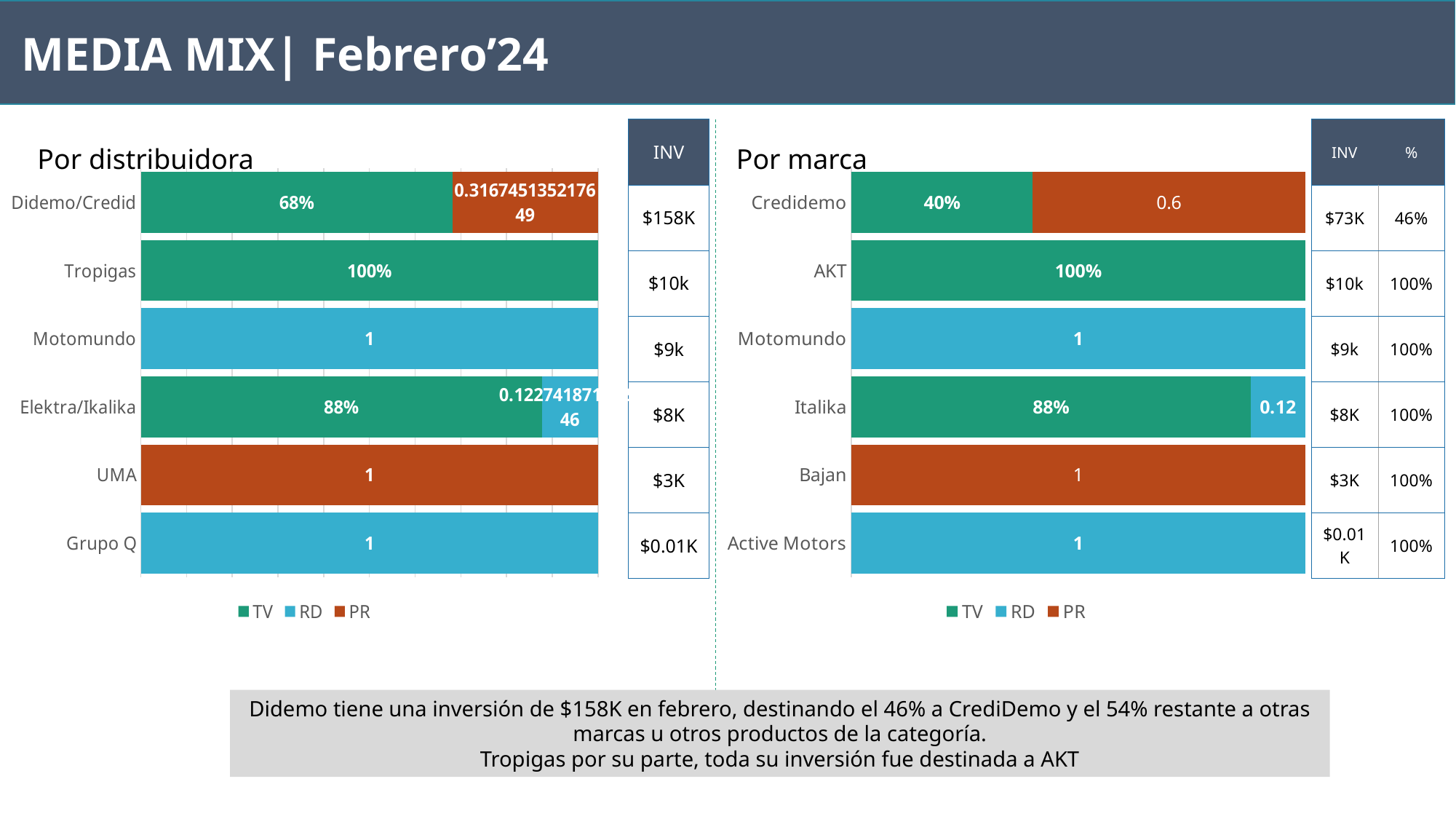
In the 'Por distribuidora' chart, how many distributors are listed? 6 In the 'Por marca' chart, what is the TV share for Credidemo? 40% In the 'Por distribuidora' chart, what is the TV share for Elektra/Ikalika? 88% In the 'Por distribuidora' chart, which series makes up the entire bar for UMA? PR In the 'Por marca' chart, what is the difference between the TV share of AKT and the TV share of Credidemo? 60% What type of chart is the 'Por marca' chart? Stacked bar chart In the 'Por distribuidora' chart, what is the TV share for Tropigas? 100% In the 'Por distribuidora' chart, what is the TV share for Didemo/Credid? 68% In the 'Por marca' chart, what is the PR value shown for Credidemo? 0.6 In the 'Por marca' chart, which has a larger TV share, Credidemo or Italika? Italika In the 'Por marca' chart, what is the RD value shown for Italika? 0.12 In the 'Por distribuidora' chart, how many series does the legend list? 3